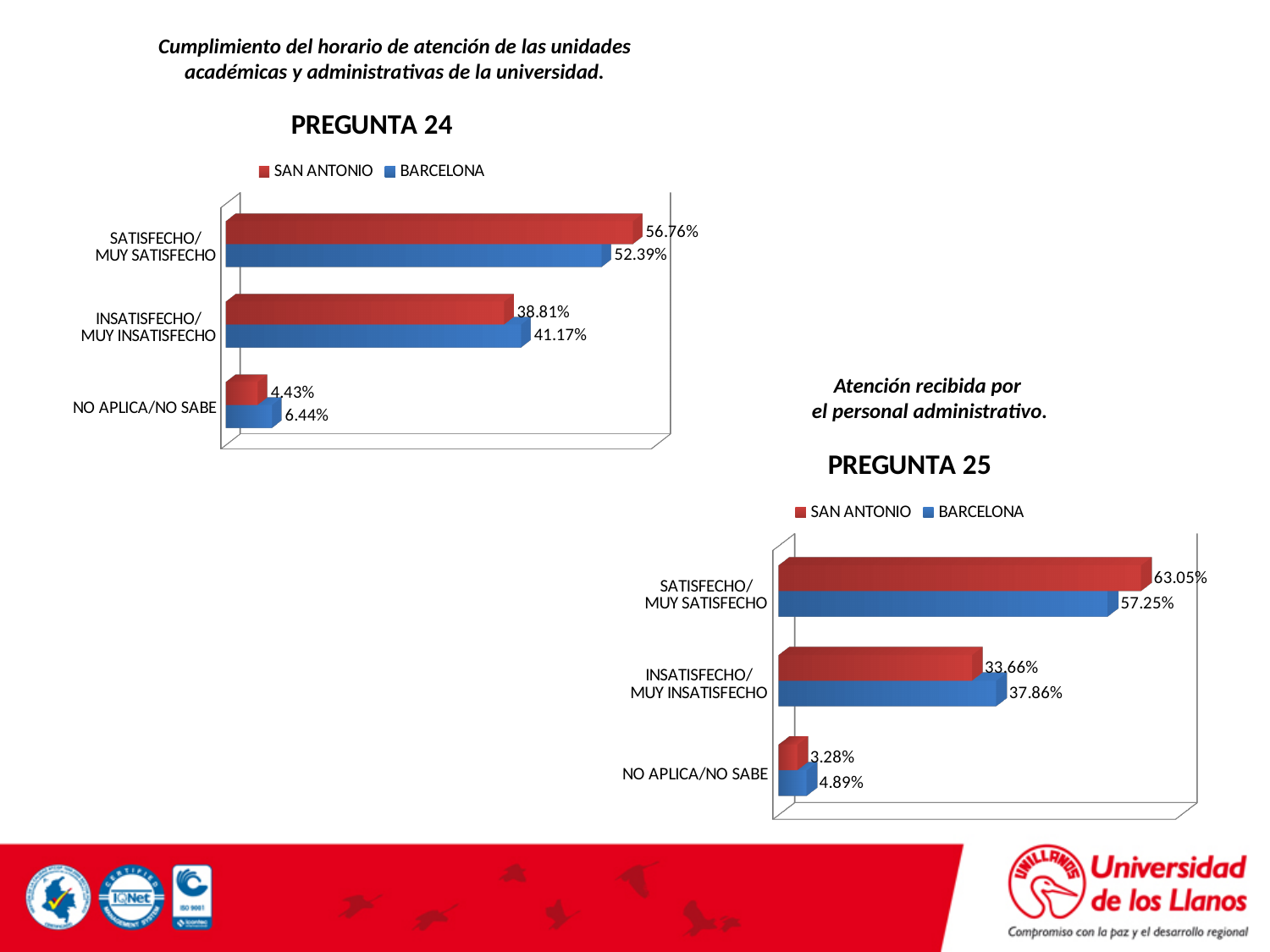
In the PREGUNTA 24 chart, what is the value for BARCELONA in the INSATISFECHO/MUY INSATISFECHO category? 41.17% In the PREGUNTA 25 chart, which category has the highest value for SAN ANTONIO? SATISFECHO/MUY SATISFECHO In the PREGUNTA 25 chart, what is the value for BARCELONA in the SATISFECHO/MUY SATISFECHO category? 57.25% In the PREGUNTA 25 chart, what is the difference between the SAN ANTONIO and BARCELONA values for SATISFECHO/MUY SATISFECHO? 5.80% In the PREGUNTA 24 chart, which is larger for INSATISFECHO/MUY INSATISFECHO, SAN ANTONIO or BARCELONA? BARCELONA In the PREGUNTA 25 chart, what is the value for SAN ANTONIO in the NO APLICA/NO SABE category? 3.28% In the PREGUNTA 25 chart, how many categories are shown? 3 In the PREGUNTA 24 chart, what is the difference between the SAN ANTONIO and BARCELONA values for NO APLICA/NO SABE? 2.01% What kind of chart is the PREGUNTA 25 chart? Bar chart In the PREGUNTA 24 chart, what is the value for SAN ANTONIO in the SATISFECHO/MUY SATISFECHO category? 56.76% In the PREGUNTA 24 chart, how many series does the legend list? 2 In the PREGUNTA 24 chart, which category has the lowest value for BARCELONA? NO APLICA/NO SABE